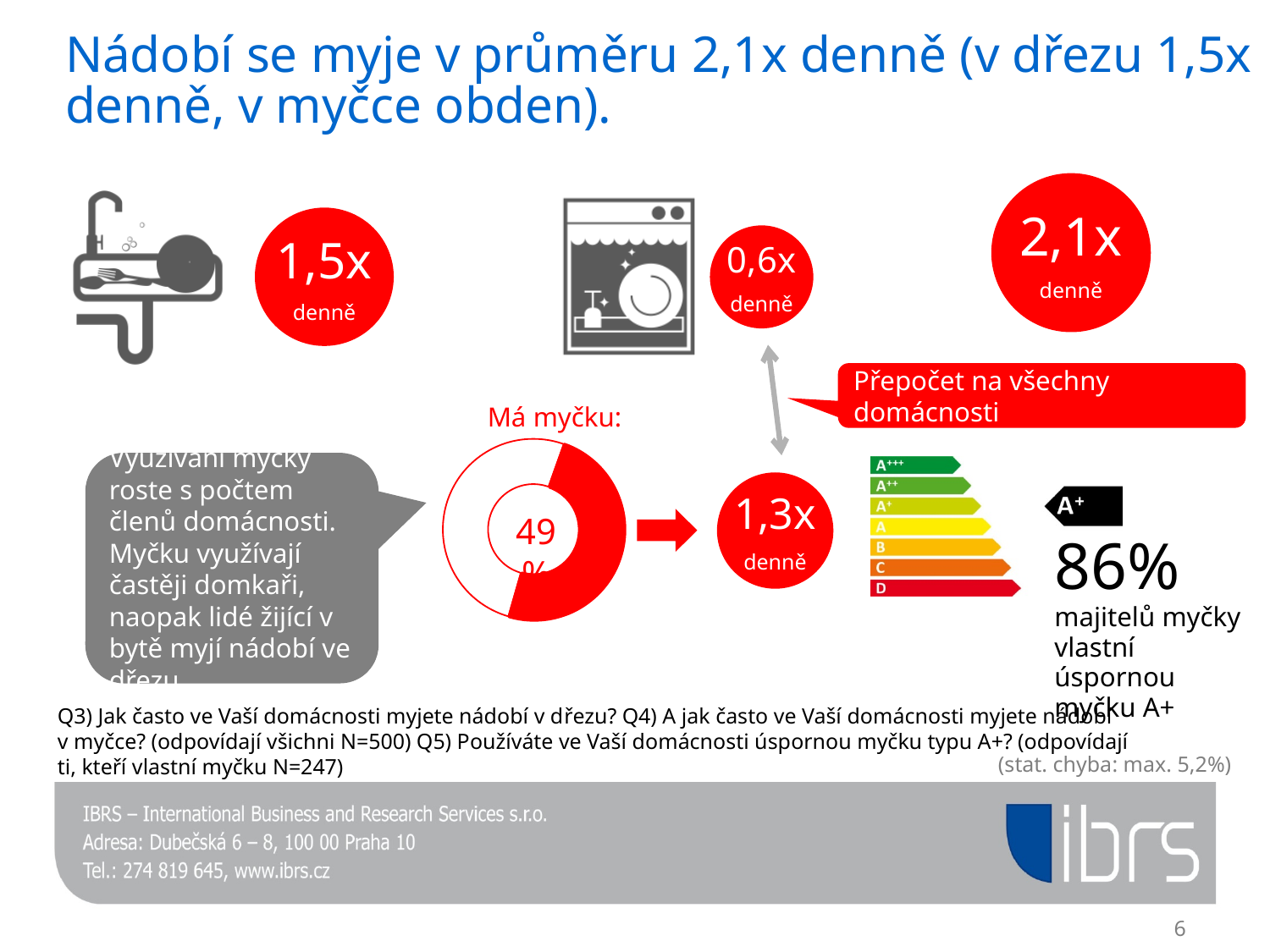
What is the heading printed above the doughnut chart? Má myčku: What colour is the slice of the doughnut chart that represents households with a dishwasher? red How many slices does the "Má myčku:" doughnut chart have? 2 What kind of chart is shown under the heading "Má myčku:"? doughnut chart In the "Má myčku:" chart, what percentage is printed in the centre of the doughnut? 49 % In the "Má myčku:" chart, is the value of the red slice greater or less than 50%? less In the "Má myčku:" chart, what share of the doughnut does the red slice represent? 49 %